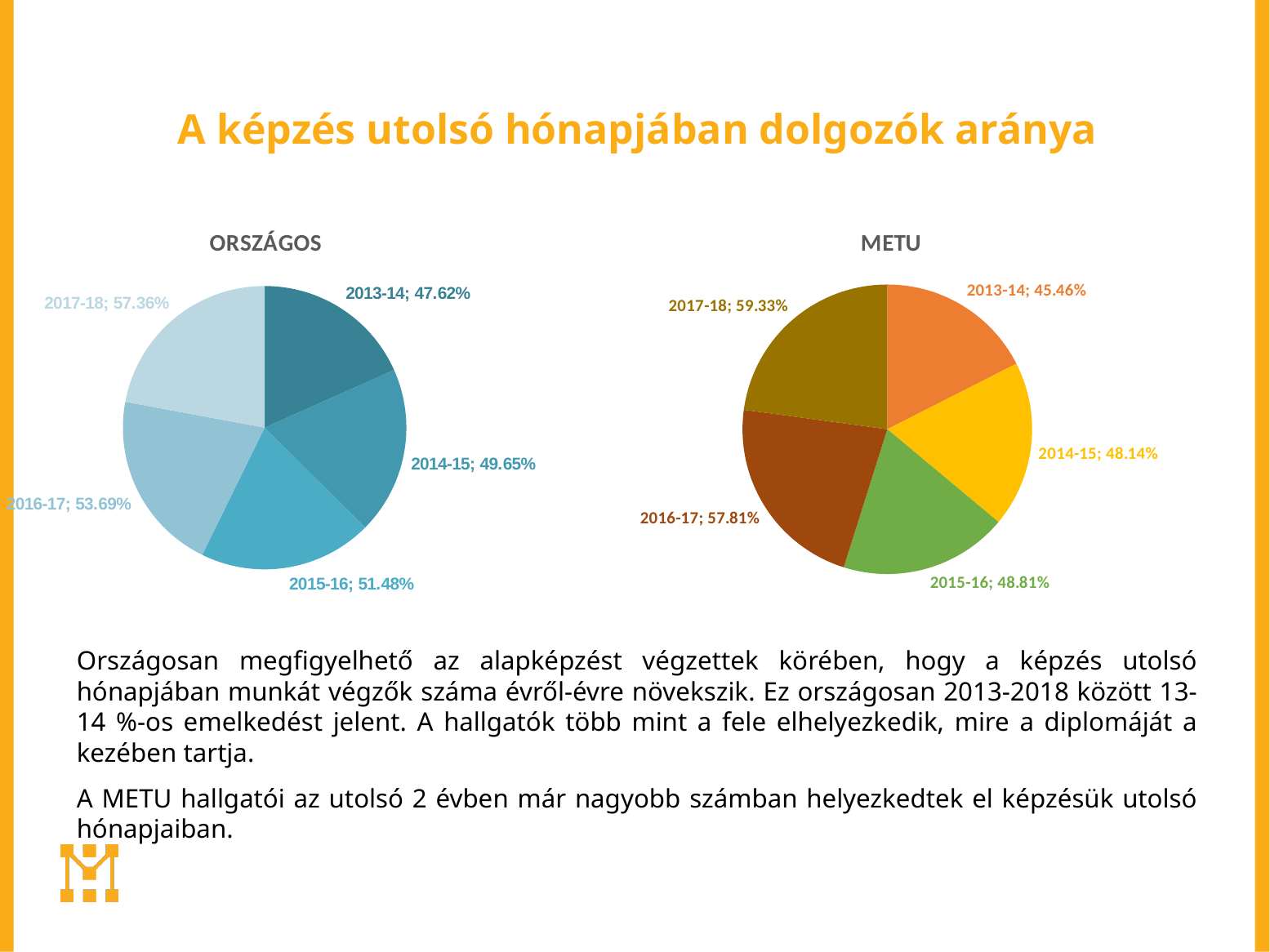
In the METU chart, what is the value for 2016-17? 57.81% In the ORSZÁGOS chart, what is the difference between the values for 2017-18 and 2013-14? 9.74% In the ORSZÁGOS chart, what is the value for 2017-18? 57.36% In the METU chart, which year has the highest value? 2017-18 What type of chart is the ORSZÁGOS chart? Pie chart In the ORSZÁGOS chart, what is the value for 2015-16? 51.48% In the ORSZÁGOS chart, which year has the lowest value? 2013-14 In the ORSZÁGOS chart, do the values rise or fall from 2013-14 to 2017-18? Rise In the METU chart, what is the value for 2013-14? 45.46% Which is larger: the 2014-15 value in the ORSZÁGOS chart or the 2014-15 value in the METU chart? ORSZÁGOS (49.65%) In the METU chart, what is the difference between the values for 2016-17 and 2015-16? 9.00% How many slices does the METU pie chart have? 5